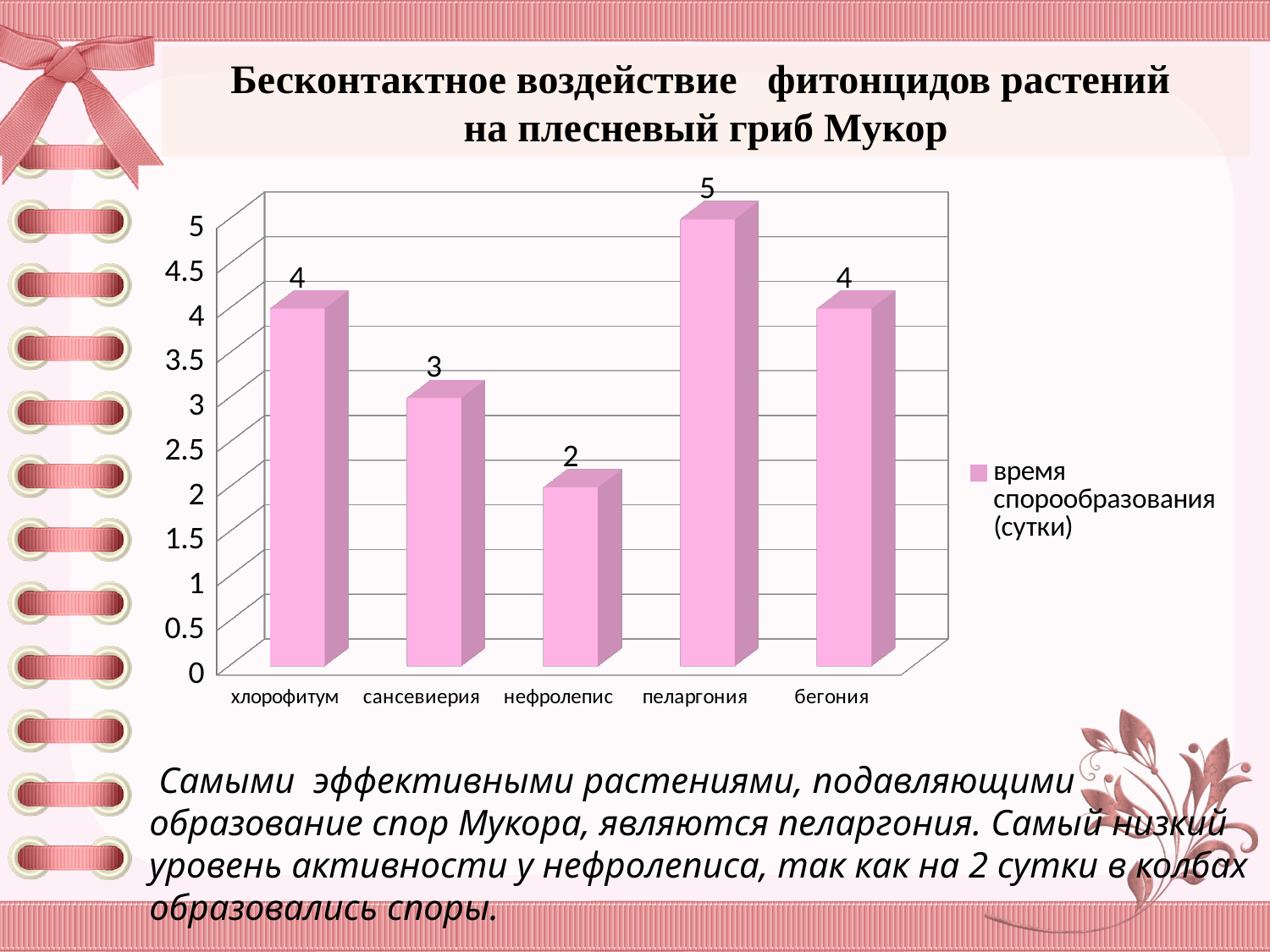
Which category has the lowest value? нефролепис What is the difference between the values for пеларгония and нефролепис? 3 How many categories are shown on the x axis? 5 What is the value for пеларгония? 5 What is the value for нефролепис? 2 How many series does the legend list? 1 What is the value for сансевиерия? 3 Which is larger, the value for хлорофитум or the value for сансевиерия? хлорофитум Which category has the highest value? пеларгония Is the value for бегония greater or less than 3? greater What kind of chart is shown on the slide? bar chart What is the legend entry for the series? время спорообразования (сутки)